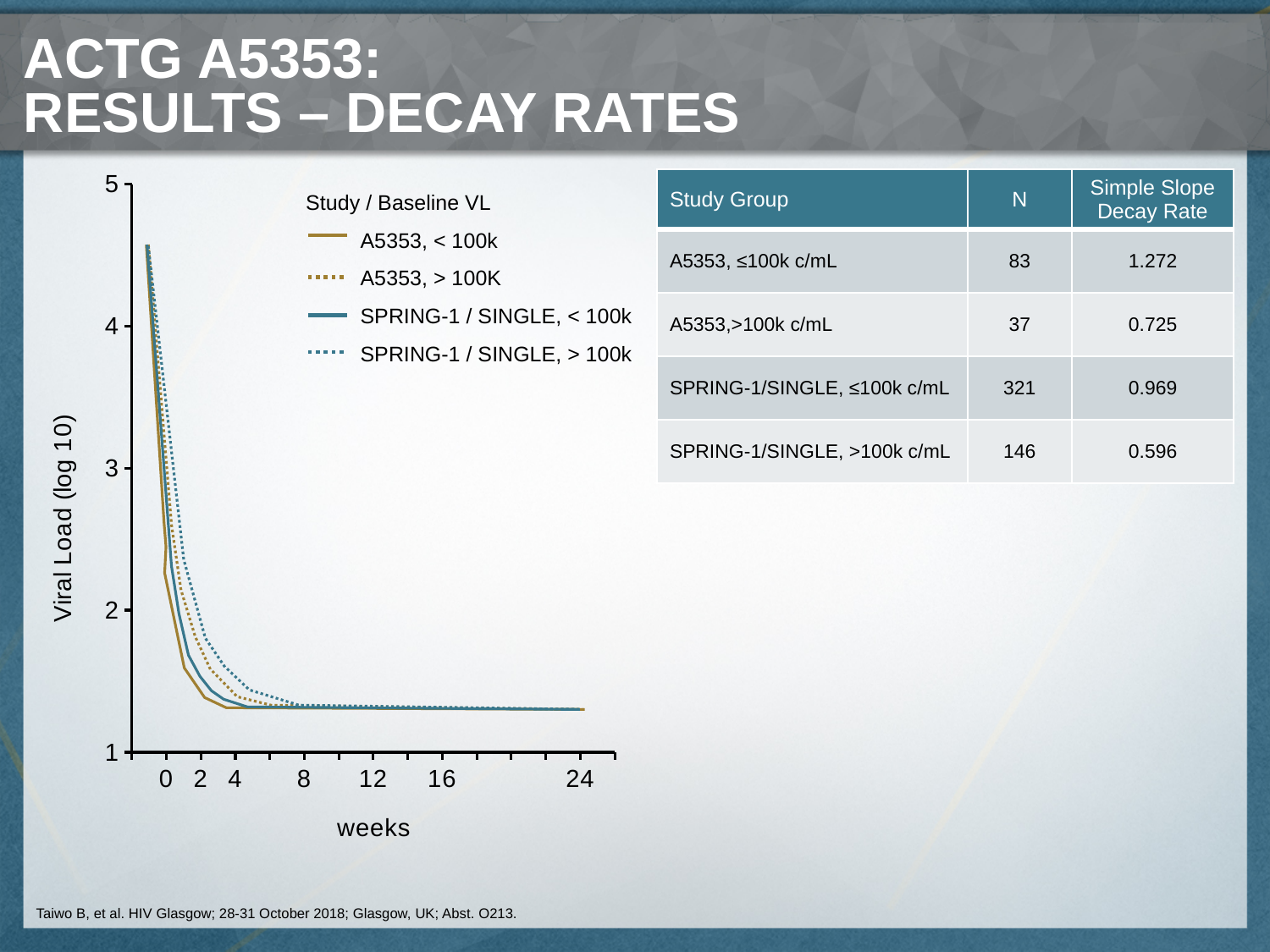
How many series does the chart legend list? 4 What kind of chart is shown on the slide? line chart At week 2, which series has the higher viral load: A5353, < 100k or SPRING-1 / SINGLE, > 100k? SPRING-1 / SINGLE, > 100k What is the title of the chart legend? Study / Baseline VL Do the viral load values rise or fall along the x axis from week 0 to week 24? fall What is the label of the y axis of the chart? Viral Load (log 10) Is the viral load for A5353, > 100K at week 8 greater or less than 2? less Is the viral load for SPRING-1 / SINGLE, > 100k at week 24 greater or less than 2? less